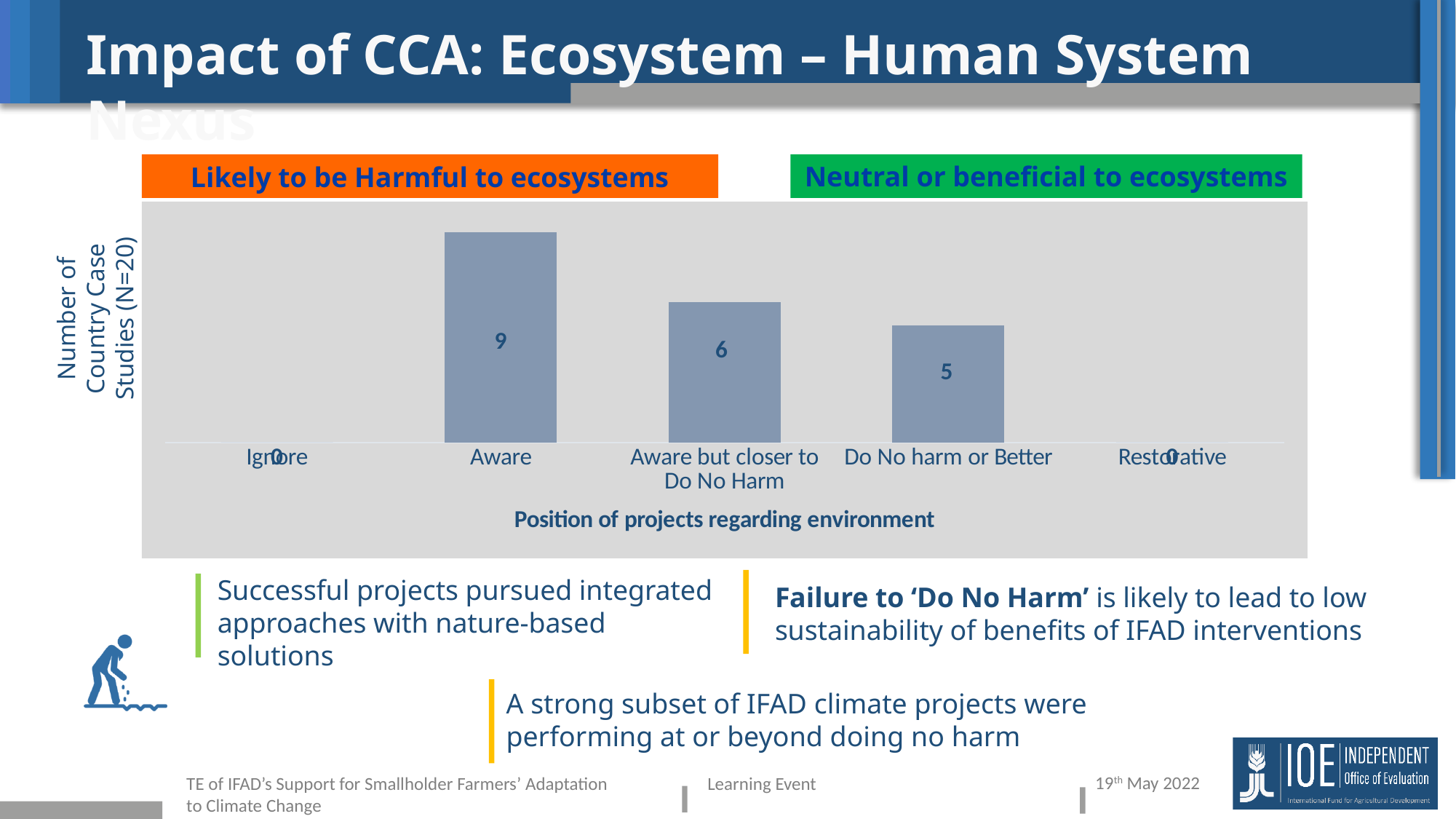
What is the x-axis title of the chart? Position of projects regarding environment What is the number of country case studies for 'Do No harm or Better'? 5 What is the number of country case studies for the 'Aware' category? 9 What is the y-axis title of the chart? Number of Country Case Studies (N=20) What is the difference between the number of country case studies for 'Aware' and for 'Do No harm or Better'? 4 What is the number of country case studies for 'Aware but closer to Do No Harm'? 6 What is the total number of country case studies across the 'Aware', 'Aware but closer to Do No Harm' and 'Do No harm or Better' categories? 20 What kind of chart is shown on the slide? Bar chart Which category has the highest number of country case studies? Aware What is the number of country case studies for the 'Ignore' category? 0 How many categories are shown on the x axis of the chart? 5 Which has more country case studies: 'Aware but closer to Do No Harm' or 'Do No harm or Better'? Aware but closer to Do No Harm